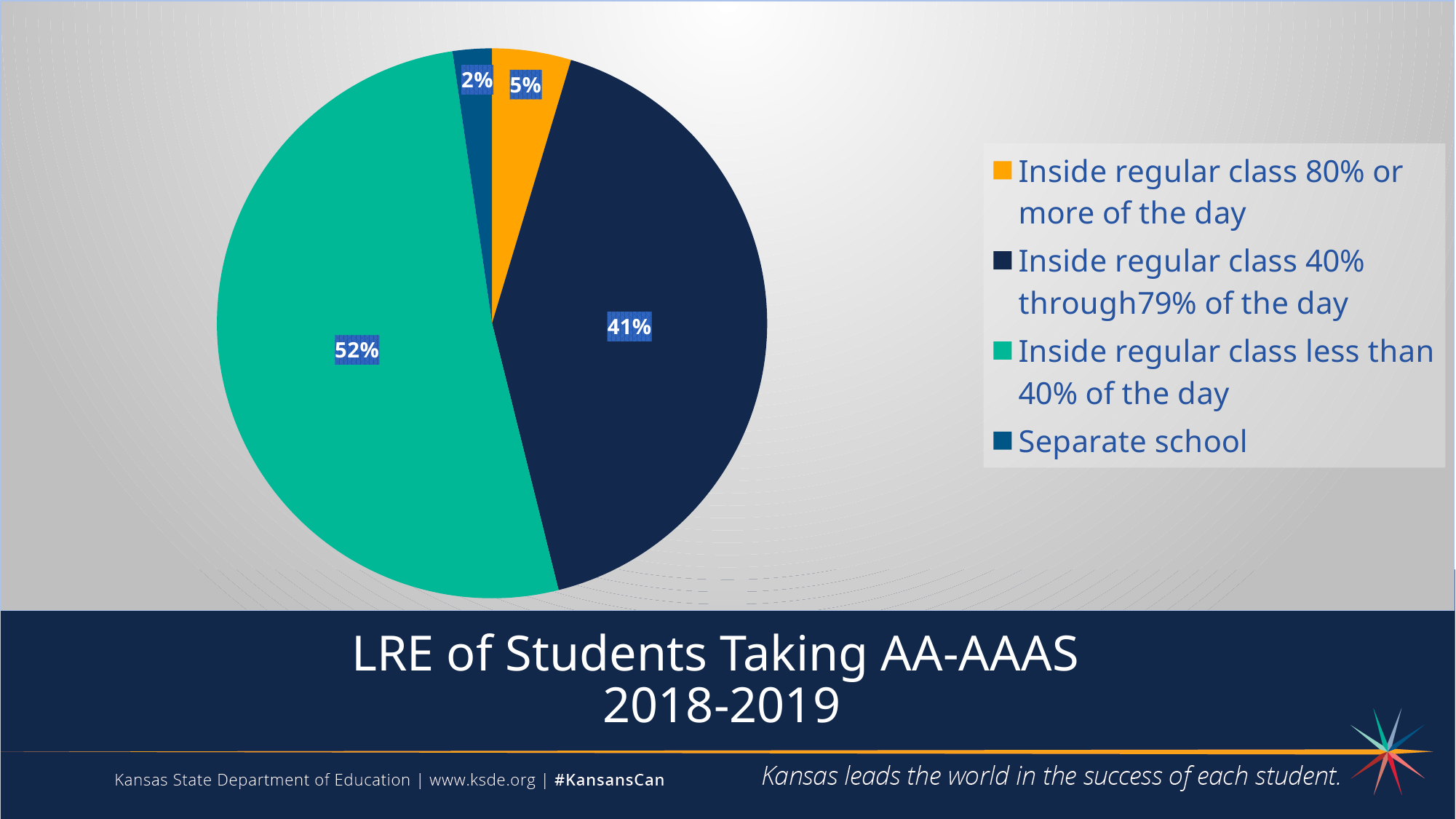
What type of chart is shown on the slide? pie chart How many categories does the pie chart show? 4 What percentage of students are inside regular class 80% or more of the day? 5% What is the title of the chart shown on the slide? LRE of Students Taking AA-AAAS 2018-2019 What percentage of students are inside regular class 40% through 79% of the day? 41% What percentage of students are inside regular class less than 40% of the day? 52% Which category has the largest share of the pie? Inside regular class less than 40% of the day What percentage of students are in a separate school? 2% What colour is the slice for 'Separate school'? blue Which is larger: the share for 'Inside regular class 80% or more of the day' or the share for 'Separate school'? Inside regular class 80% or more of the day Which category has the smallest share of the pie? Separate school What is the difference in percentage points between the 'Inside regular class less than 40% of the day' slice and the 'Inside regular class 40% through 79% of the day' slice? 11